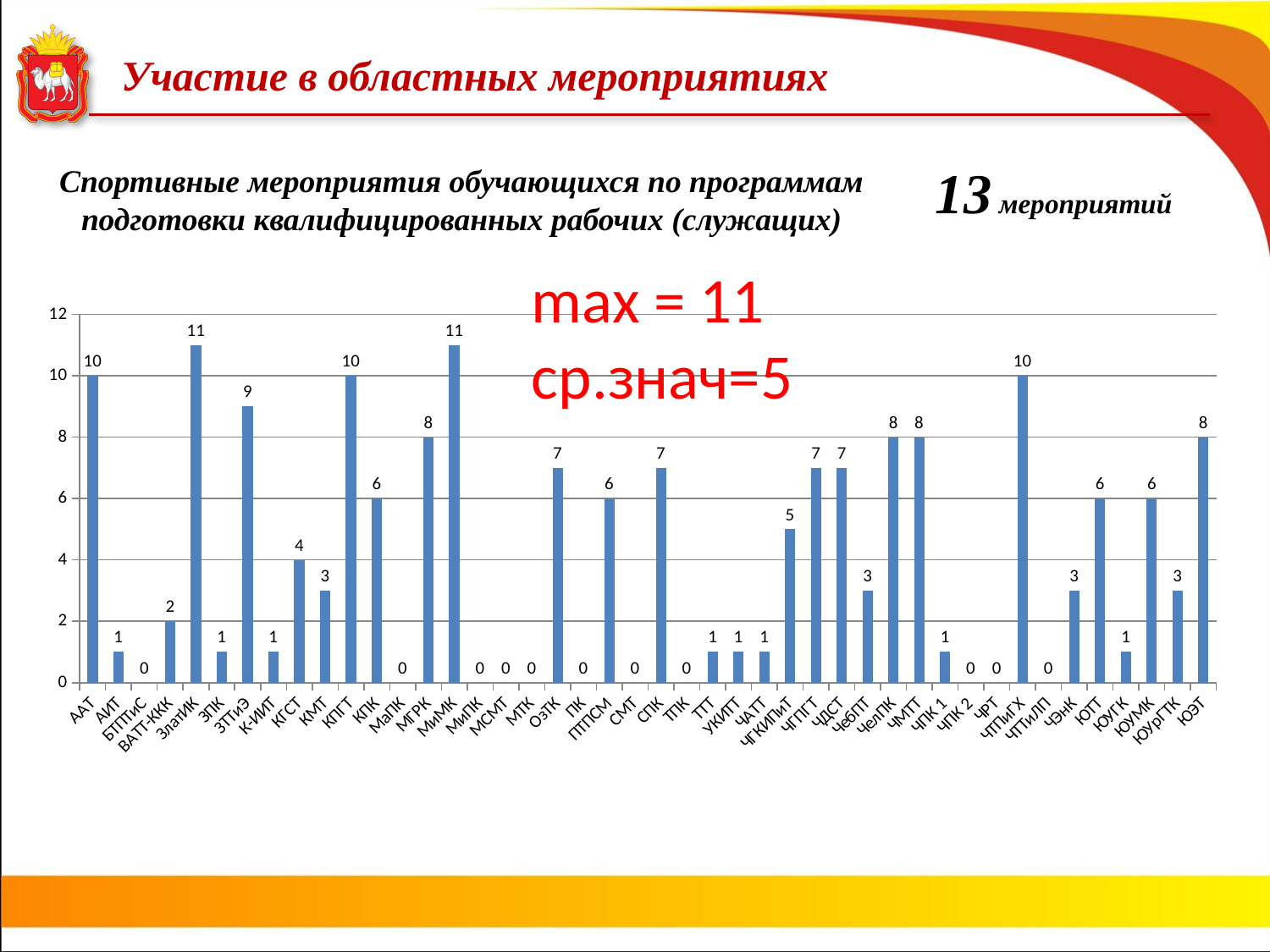
What maximum value is written in red text above the chart? max = 11 What is the difference between the values for ААТ and КМТ? 7 What is the highest value shown on the chart? 11 What is the value for ЧТПиГХ? 10 What is the value for КГСТ? 4 Is the value for ЧелПК greater or less than 6? greater Which has a larger value, МГРК or ОЗТК? МГРК What is the value for ЗТТиЭ? 9 What is the value for ЧГКИПиТ? 5 What type of chart is shown on the slide? bar chart What is the value for ВАТТ-ККК? 2 What is the difference between the values for ЮЭТ and ЮУрГТК? 5